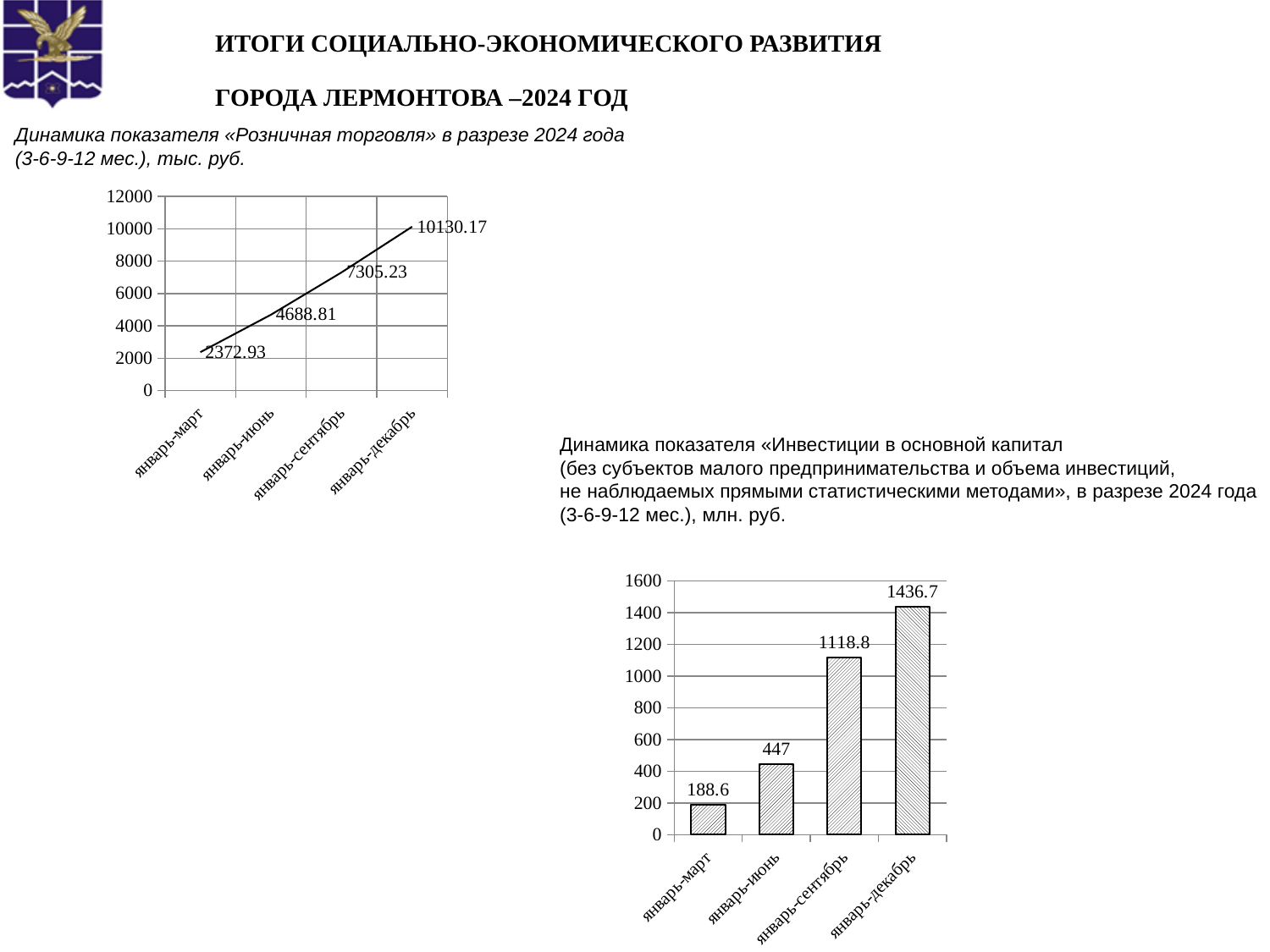
In the retail trade chart (top left), what kind of chart is shown? line chart In the investments chart (bottom right), what is the difference between the values for январь-декабрь and январь-сентябрь? 317.9 In the retail trade chart (top left), what is the value for январь-декабрь? 10130.17 In the investments chart (bottom right), which period has the lowest value? январь-март In the investments chart (bottom right), what kind of chart is shown? bar chart In the retail trade chart (top left), what is the value for январь-июнь? 4688.81 In the retail trade chart (top left), how many data points are plotted? 4 In the investments chart (bottom right), what is the value for январь-март? 188.6 In the retail trade chart (top left), what is the difference between the values for январь-сентябрь and январь-июнь? 2616.42 In the retail trade chart (top left), do the values rise or fall from январь-март to январь-декабрь? rise In the investments chart (bottom right), which period has the highest value? январь-декабрь In the investments chart (bottom right), what is the value for январь-сентябрь? 1118.8